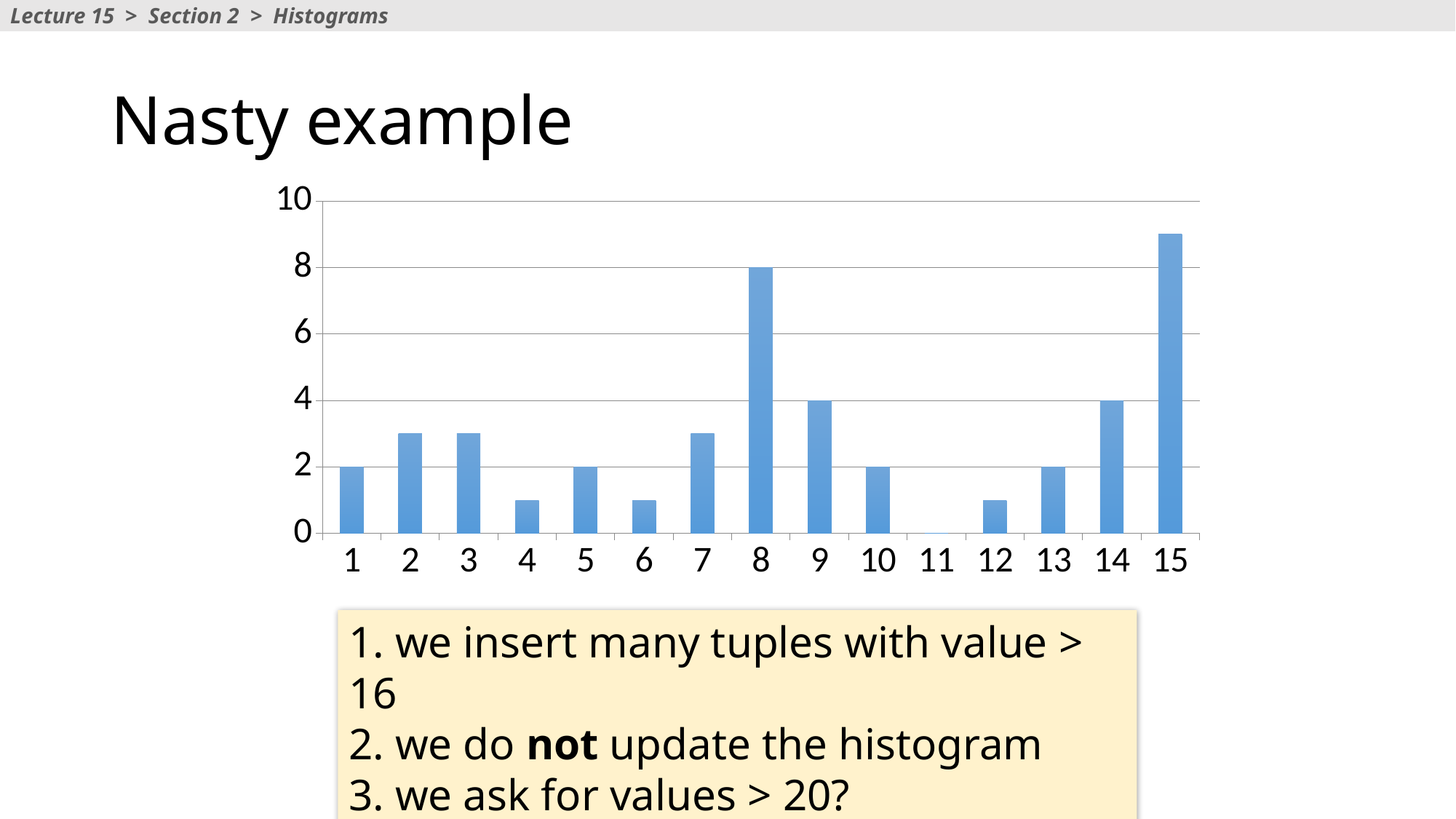
What is the value for category 1 in the chart? 2 What is the value for category 14 in the chart? 4 Which category has the tallest bar in the chart? 15 What is the value for category 9 in the chart? 4 What is the difference between the values for category 8 and category 9? 4 Which category has the lowest value in the chart? 11 What kind of chart is shown on the slide? bar chart How many categories are shown on the x axis of the chart? 15 Is the value for category 4 greater or less than 2? less What is the value for category 8 in the chart? 8 Is the value for category 15 greater or less than 8? greater Which has the larger value, category 8 or category 15? 15